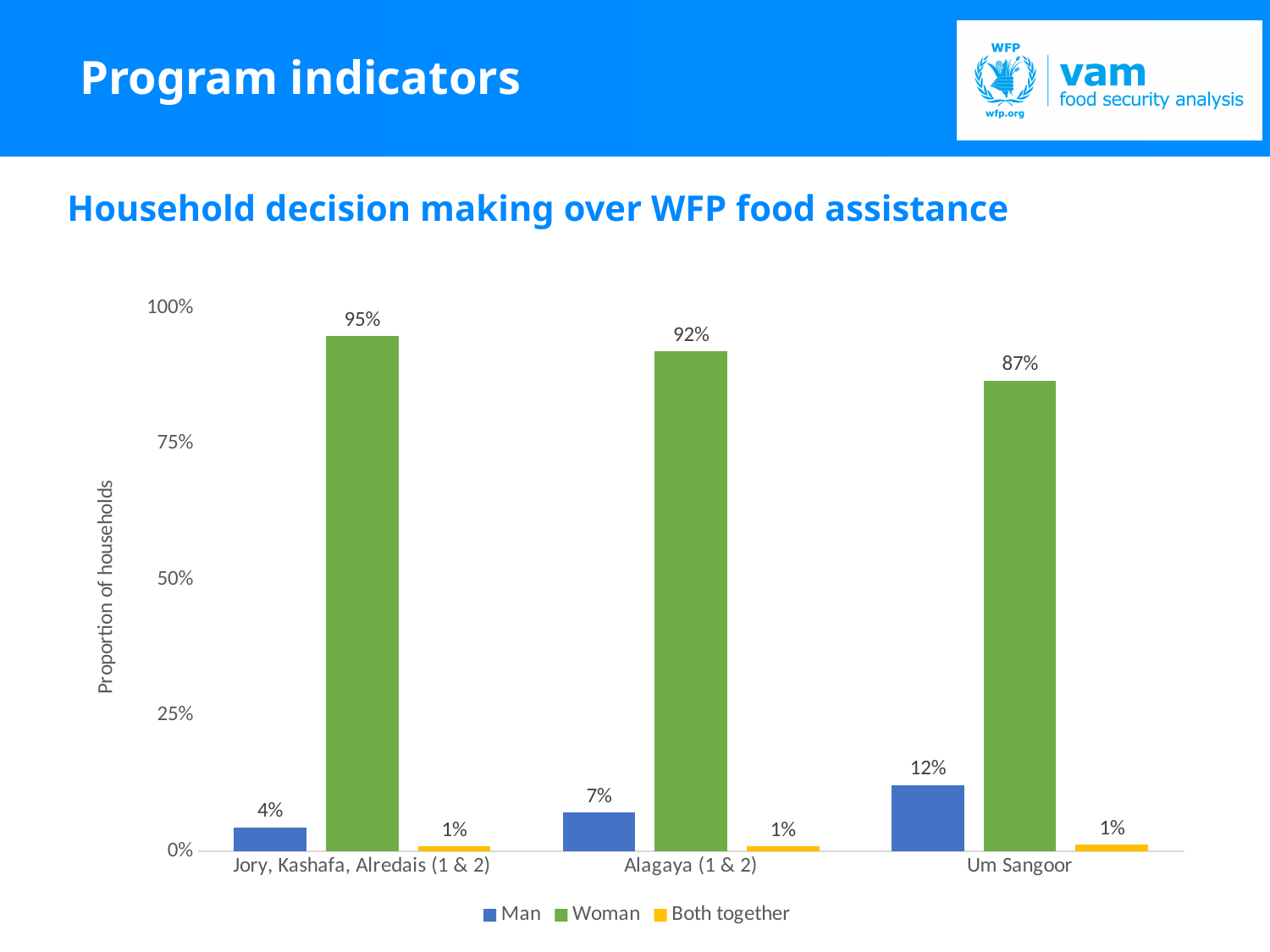
How many series does the legend list? 3 Which location has the lowest value for Woman? Um Sangoor What is the value for Man in Um Sangoor? 12% Which location has the highest value for Man? Um Sangoor What is the difference between the Woman and Man values in Alagaya (1 & 2)? 85% Is the value for Woman in Um Sangoor greater or less than 75%? greater What is the value for Woman in Jory, Kashafa, Alredais (1 & 2)? 95% What kind of chart is shown? Bar chart What is the label of the y axis? Proportion of households How many locations are shown on the x axis? 3 What is the value for Both together in Alagaya (1 & 2)? 1% Which is larger: the Man value in Alagaya (1 & 2) or the Man value in Jory, Kashafa, Alredais (1 & 2)? Alagaya (1 & 2)